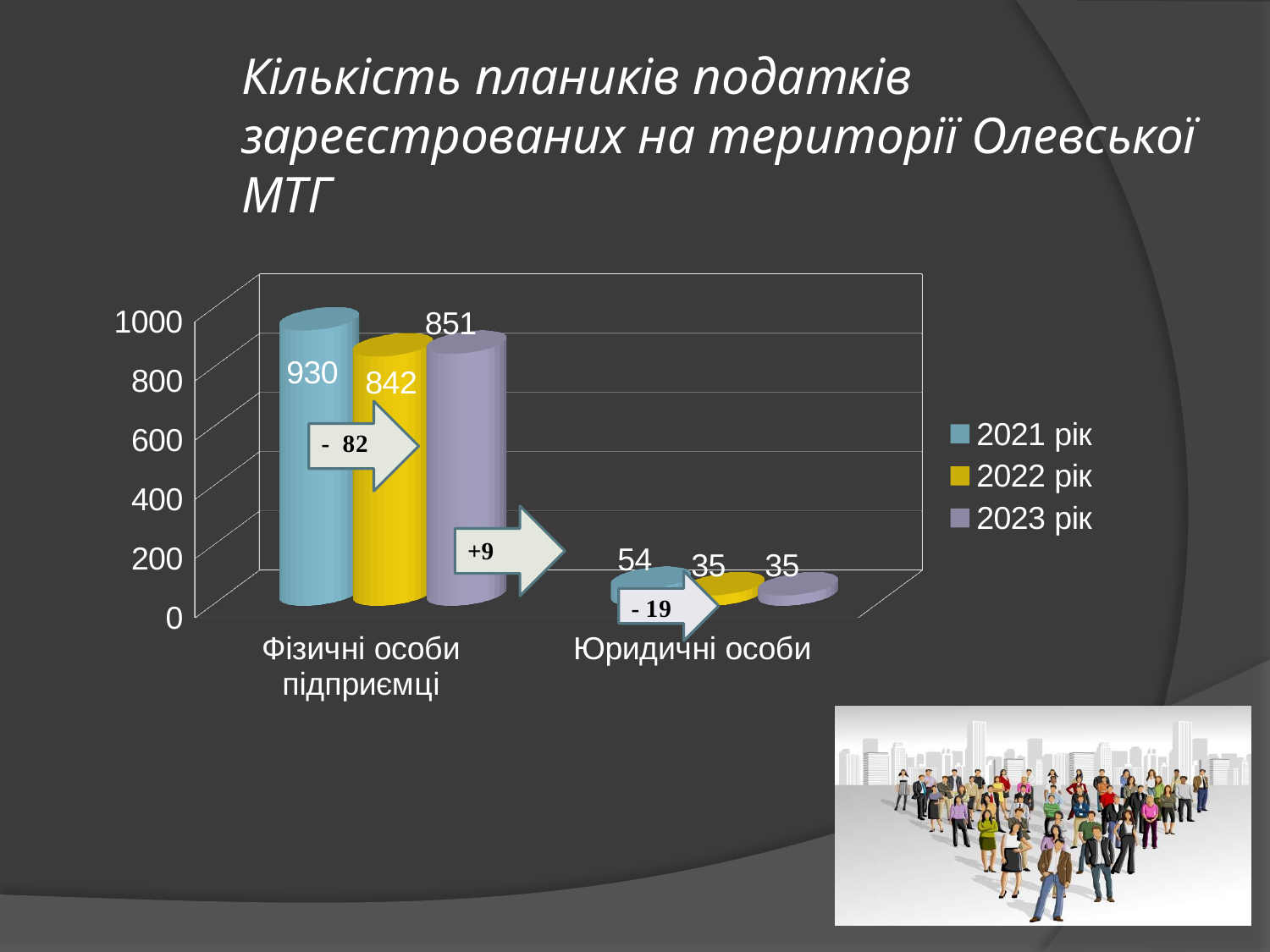
Which year has the highest value for Фізичні особи підприємці? 2021 рік What is the difference between the 2021 рік and 2022 рік values for Юридичні особи? 19 How many series does the legend list? 3 What is the value for Фізичні особи підприємці in 2021 рік? 930 What is the value for Фізичні особи підприємці in 2022 рік? 842 What is the difference between the 2021 рік and 2022 рік values for Фізичні особи підприємці? 88 Which year has the lowest value for Фізичні особи підприємці? 2022 рік What is the value for Юридичні особи in 2021 рік? 54 What kind of chart is shown on the slide? Bar chart What is the value for Фізичні особи підприємці in 2023 рік? 851 What is the value for Юридичні особи in 2023 рік? 35 Which is larger for Фізичні особи підприємці: the 2022 рік value or the 2023 рік value? 2023 рік